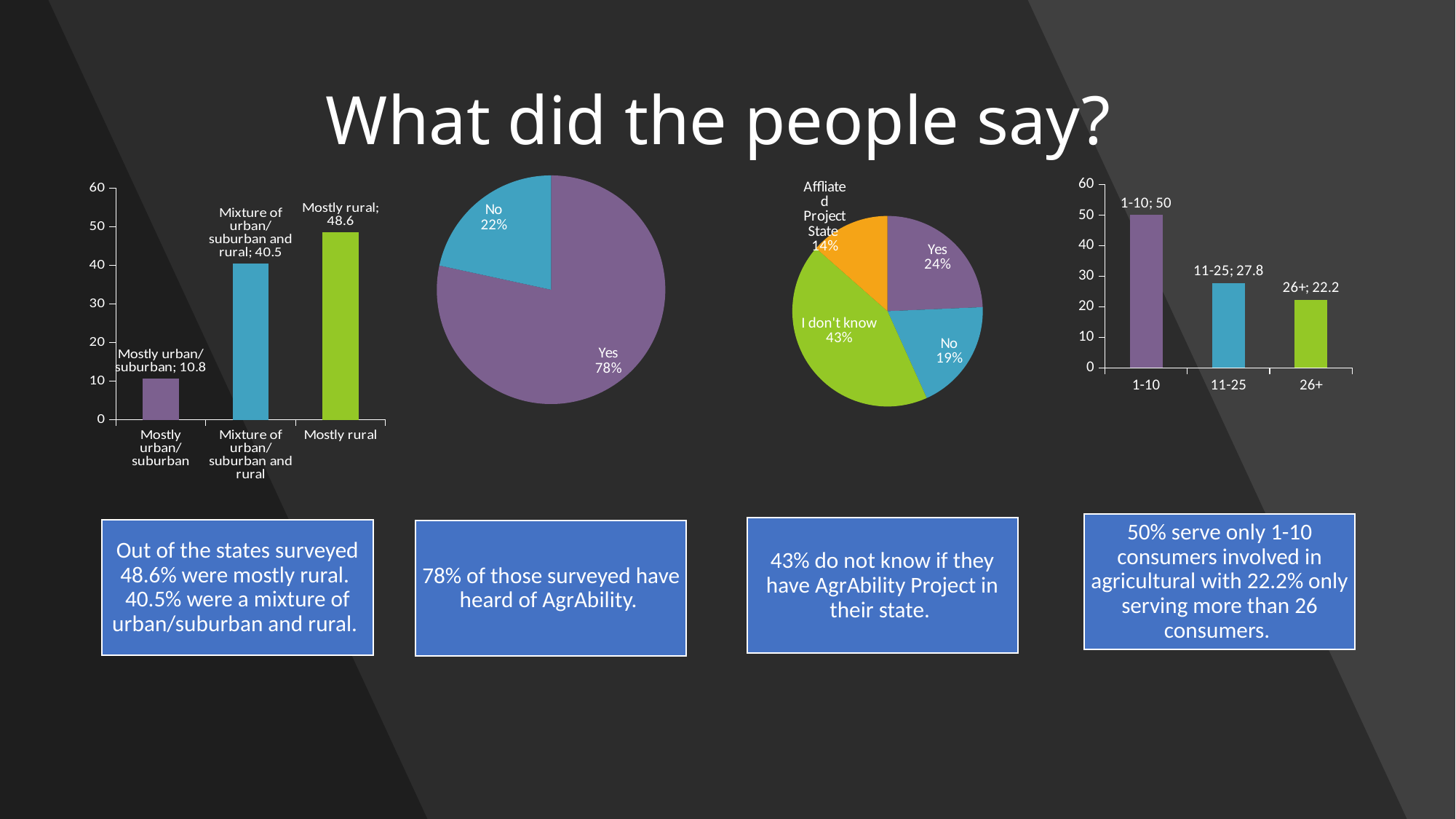
In the third chart from the left (the pie chart), what share is labelled I don't know? 43% In the third chart from the left (the pie chart), which slice is the smallest? Affliated Project State How many categories are shown in the leftmost bar chart? 3 How many slices does the third chart from the left (the pie chart) have? 4 In the leftmost bar chart, what is the difference between the Mostly rural value and the Mixture of urban/suburban and rural value? 8.1 In the rightmost bar chart, is the value for 26+ greater or less than 30? less In the rightmost bar chart, which category has the highest value? 1-10 In the second chart from the left (the pie chart), what share is labelled Yes? 78% In the rightmost bar chart, what is the value for 11-25? 27.8 What kind of chart is the second chart from the left? pie chart In the leftmost bar chart, what is the value for Mostly rural? 48.6 In the leftmost bar chart, which category has the lowest value? Mostly urban/suburban